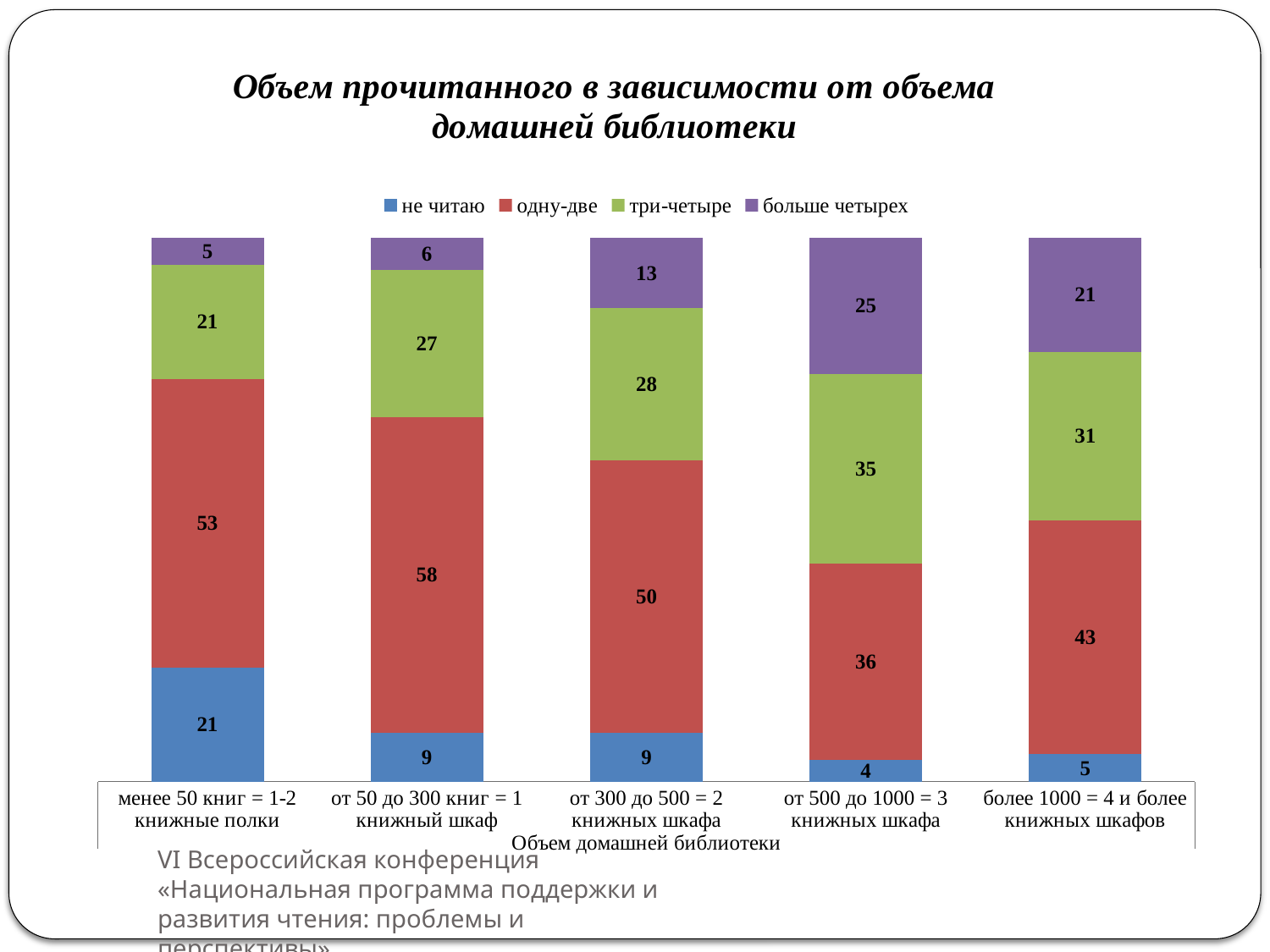
What is the value of "больше четырех" for the category "от 500 до 1000 = 3 книжных шкафа"? 25 Which category has the highest value for "не читаю"? менее 50 книг = 1-2 книжные полки Which is larger: the "одну-две" value for "от 300 до 500 = 2 книжных шкафа" or for "более 1000 = 4 и более книжных шкафов"? от 300 до 500 = 2 книжных шкафа How many categories are shown on the x axis? 5 What is the value of "не читаю" for the category "менее 50 книг = 1-2 книжные полки"? 21 What is the total of the stacked bar for "от 300 до 500 = 2 книжных шкафа"? 100 What is the value of "одну-две" for the category "от 50 до 300 книг = 1 книжный шкаф"? 58 What kind of chart is shown on the slide? stacked bar chart What is the difference between the "три-четыре" values for "от 500 до 1000 = 3 книжных шкафа" and "менее 50 книг = 1-2 книжные полки"? 14 How many series does the legend list? 4 What is the title of the chart? Объем прочитанного в зависимости от объема домашней библиотеки Which category has the lowest value for "больше четырех"? менее 50 книг = 1-2 книжные полки